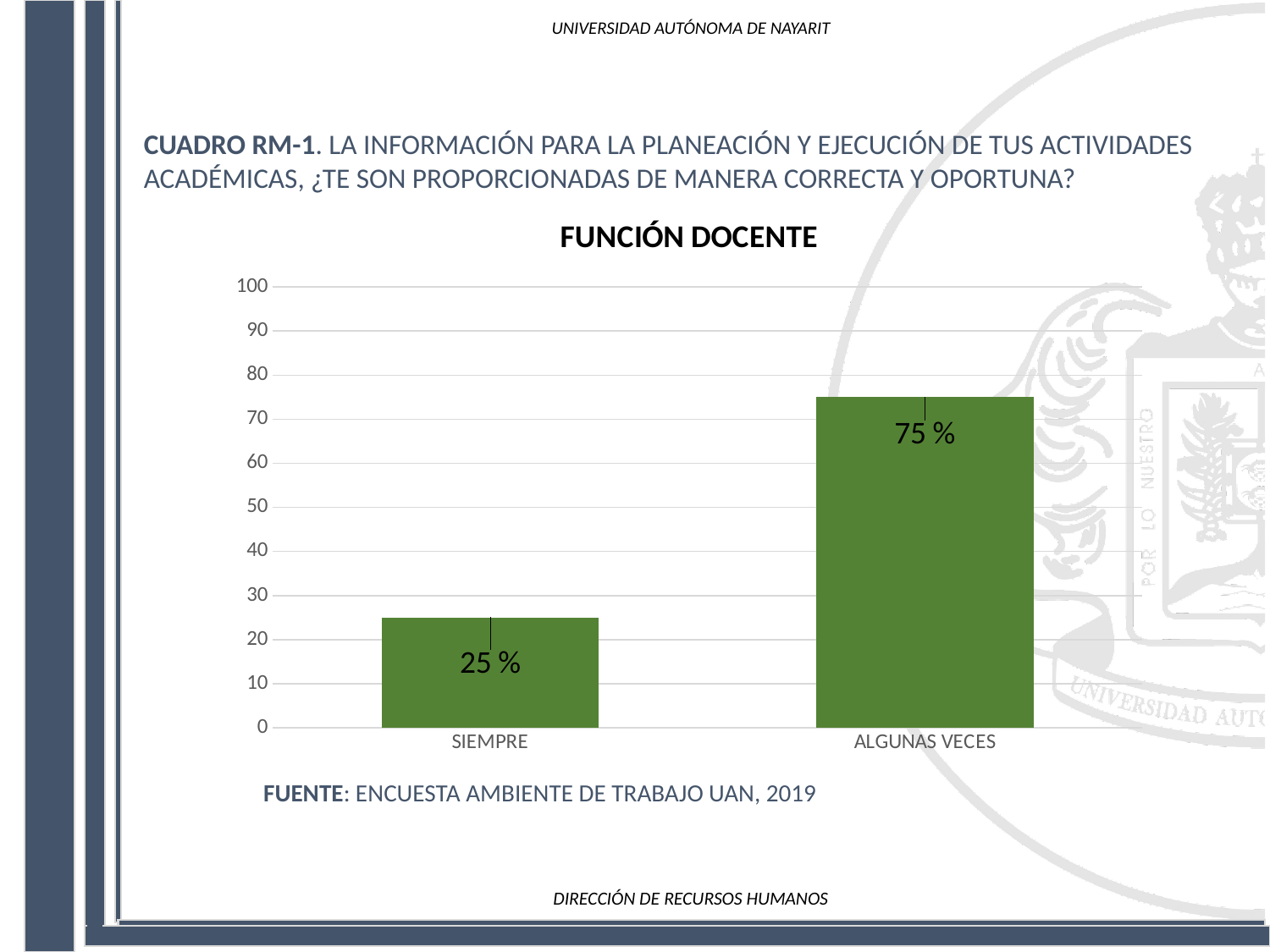
What is the difference between the values for ALGUNAS VECES and SIEMPRE? 50 % What is the value for SIEMPRE? 25 % Is the value for SIEMPRE greater or less than 30? less What is the value for ALGUNAS VECES? 75 % Which is larger, the value for SIEMPRE or the value for ALGUNAS VECES? ALGUNAS VECES Which category has the lowest value? SIEMPRE How many categories are shown on the x axis? 2 What kind of chart is shown on the slide? bar chart Is the value for ALGUNAS VECES greater or less than 50? greater What is the title of the chart? FUNCIÓN DOCENTE What colour are the bars in the chart? green Which category has the highest value? ALGUNAS VECES